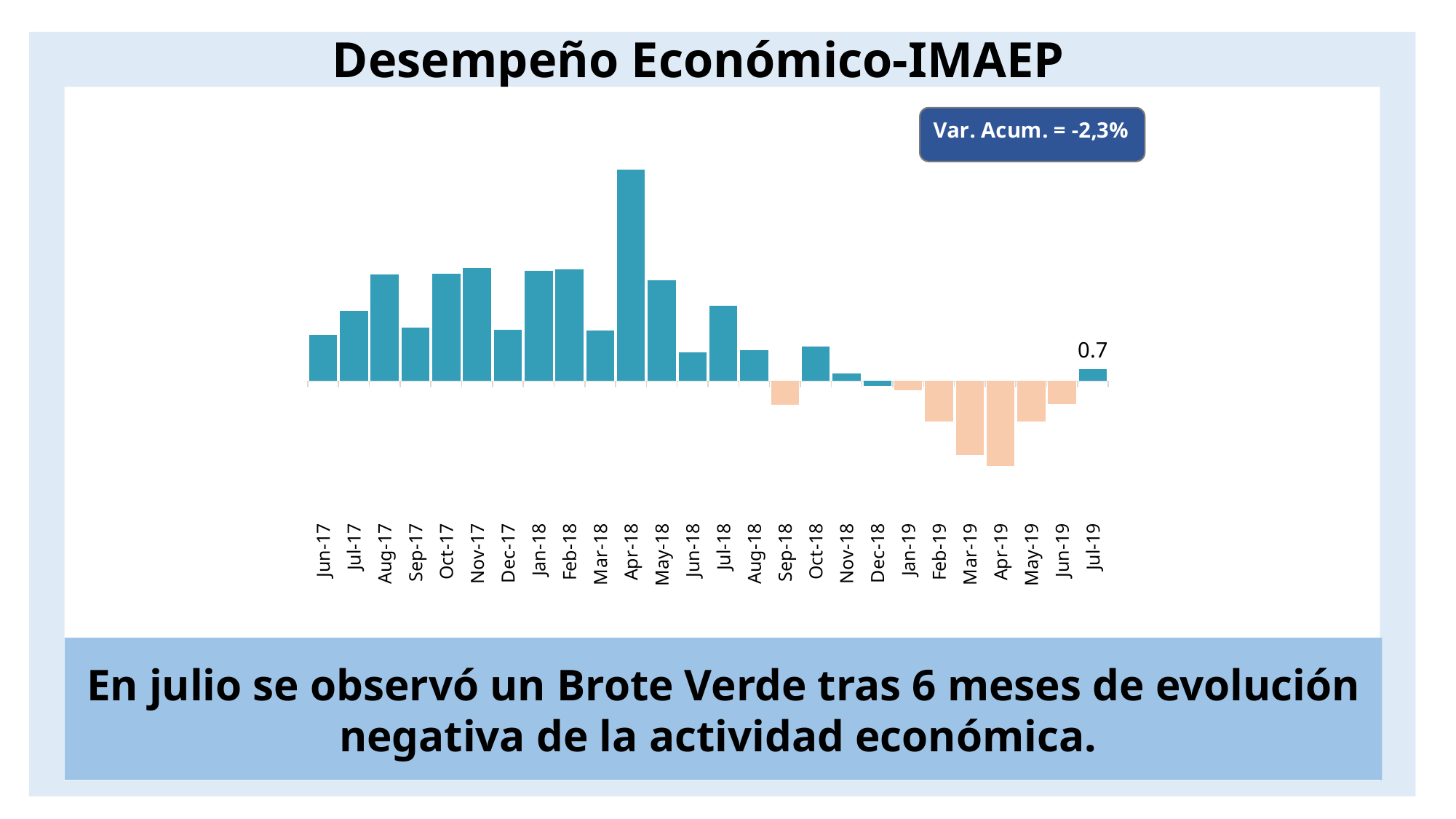
What is the value shown for Jul-19? 0.7 What accumulated variation (Var. Acum.) is shown in the box on the chart? -2,3% How many months show a negative (below zero) bar? 8 Which is larger, the value for Apr-18 or the value for May-18? Apr-18 How many consecutive months immediately before Jul-19 have negative bars? 6 How many months are plotted on the x axis? 26 Which is larger, the value for Jul-17 or the value for Aug-17? Aug-17 What is the title of the chart? Desempeño Económico-IMAEP Which is larger, the value for Oct-18 or the value for Nov-18? Oct-18 What type of chart is shown on the slide? bar chart Which month has the highest bar? Apr-18 Do the values generally rise or fall from Apr-18 to Dec-18? fall